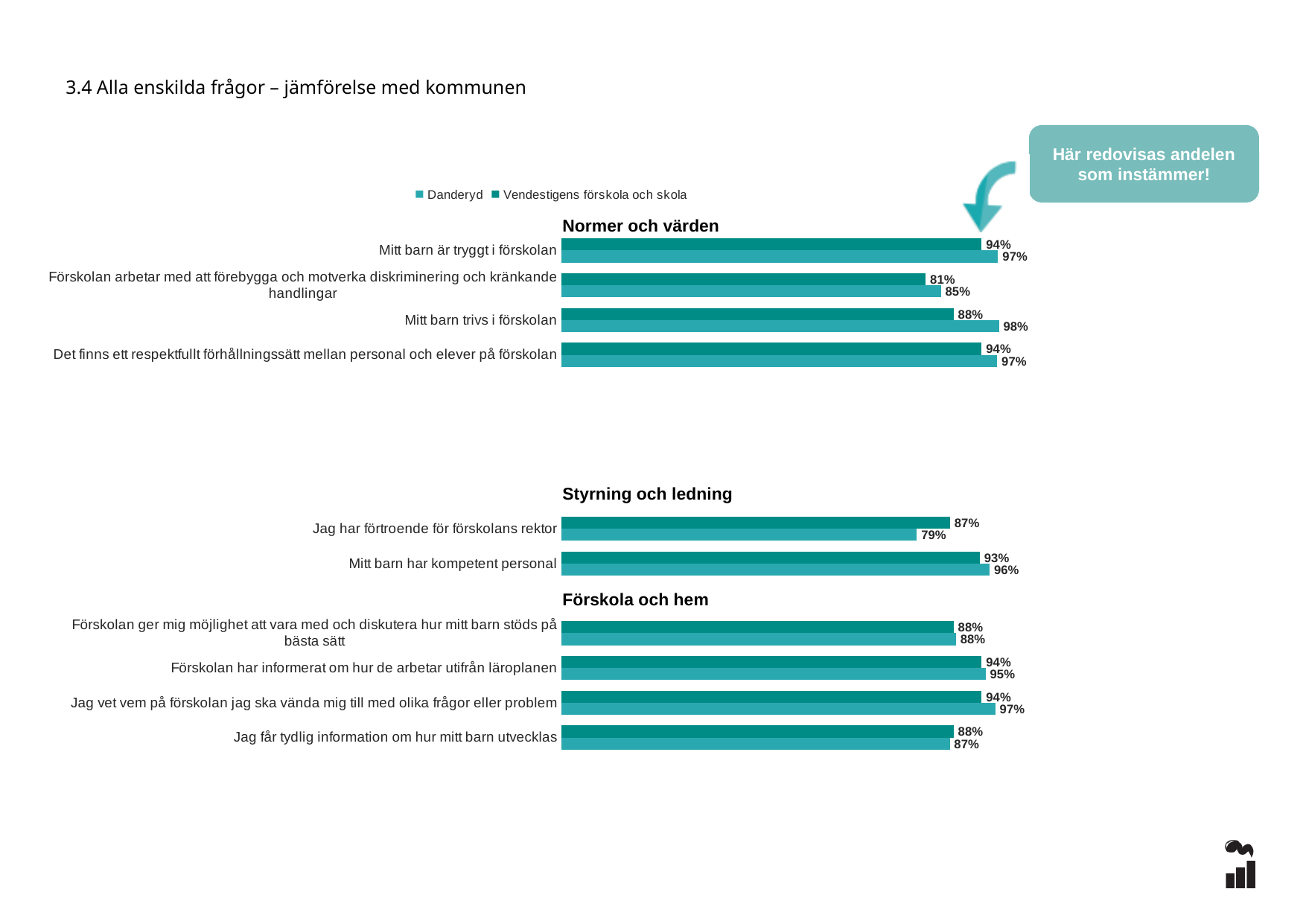
In the 'Styrning och ledning' chart, which is larger for 'Mitt barn har kompetent personal': the Danderyd value or the Vendestigens förskola och skola value? Danderyd In the 'Normer och värden' chart, what is the Vendestigens förskola och skola value for 'Förskolan arbetar med att förebygga och motverka diskriminering och kränkande handlingar'? 81% In the 'Normer och värden' chart, what is the Danderyd value for 'Mitt barn trivs i förskolan'? 98% In the 'Styrning och ledning' chart, what is the difference between the two values for 'Jag har förtroende för förskolans rektor'? 8% In the 'Styrning och ledning' chart, what is the Danderyd value for 'Jag har förtroende för förskolans rektor'? 79% In the 'Förskola och hem' chart, what is the Vendestigens förskola och skola value for 'Jag får tydlig information om hur mitt barn utvecklas'? 88% How many series does the legend list? 2 In the 'Normer och värden' chart, how many categories are shown? 4 What kind of chart is used on this slide? bar chart In the 'Förskola och hem' chart, how many categories are shown? 4 In the 'Normer och värden' chart, which category has the lowest Danderyd value? Förskolan arbetar med att förebygga och motverka diskriminering och kränkande handlingar In the 'Förskola och hem' chart, which category has the highest Danderyd value? Jag vet vem på förskolan jag ska vända mig till med olika frågor eller problem